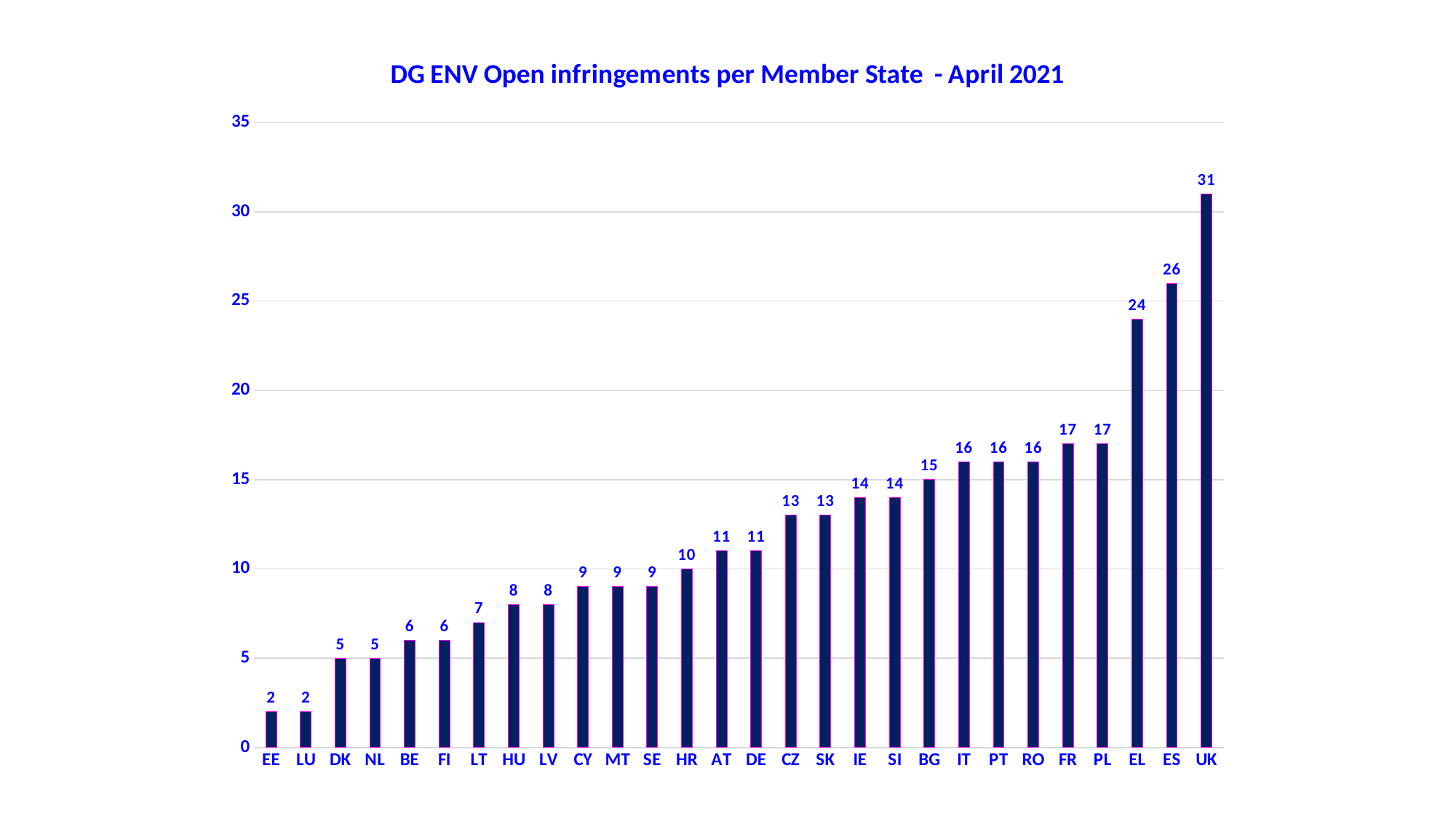
What is the title of the chart? DG ENV Open infringements per Member State - April 2021 What is the value for ES? 26 What is the difference between the values for EL and FR? 7 What is the difference between the values for UK and ES? 5 What kind of chart is shown on the slide? Bar chart Which Member State has the highest number of open infringements? UK How many open infringements are shown for HR? 10 What is the value for BG? 15 Which has a larger value, CZ or LT? CZ How many Member States are shown on the chart? 28 What is the lowest value shown on the chart? 2 Is the value for EL greater or less than 20? greater